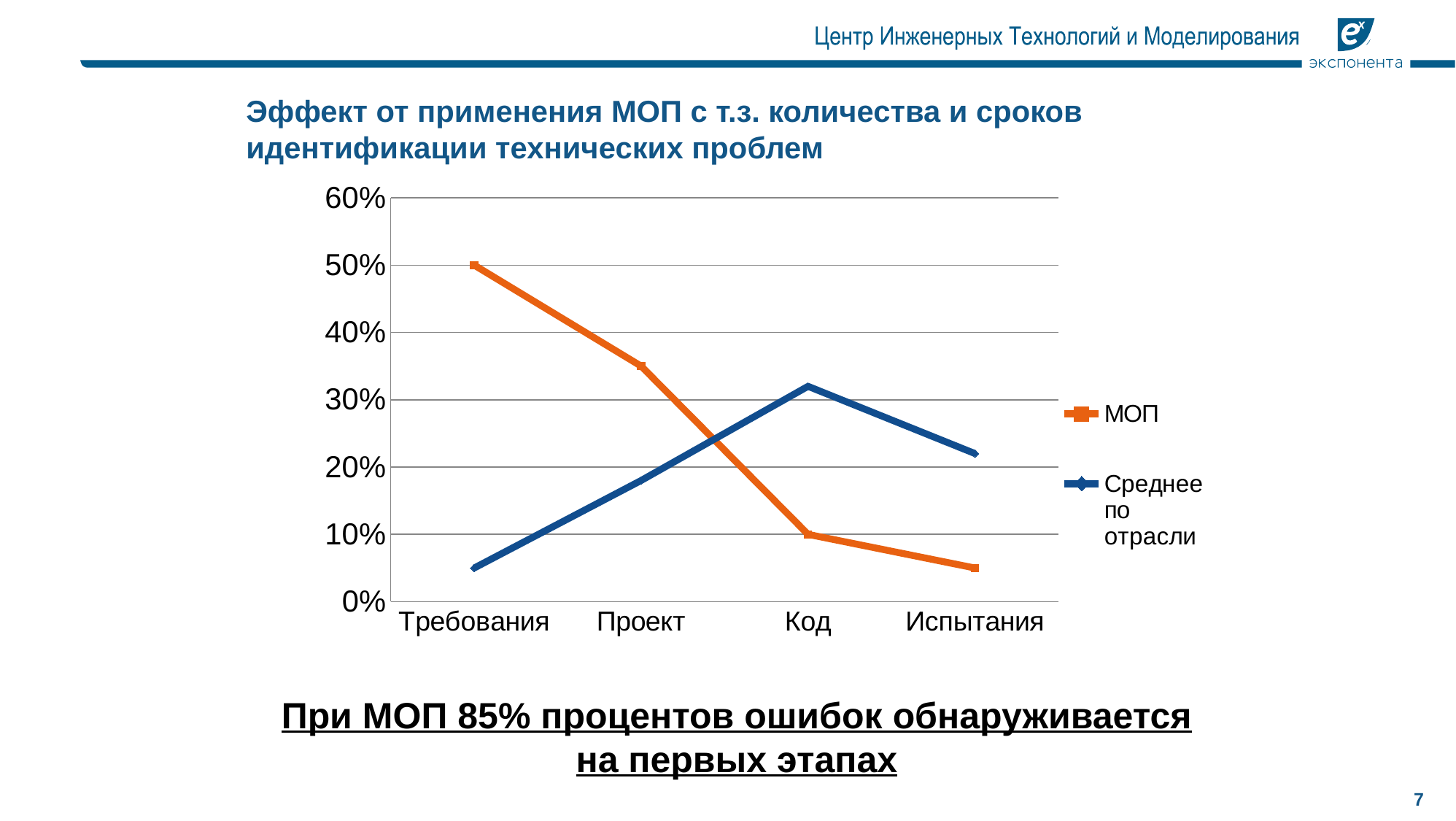
Is the value of Среднее по отрасли at Требования greater or less than 10%? less Is the value of the МОП series at Проект greater or less than 30%? greater How many categories are shown on the x axis? 4 What kind of chart is shown on the slide? line chart Which series has the larger value at Код, МОП or Среднее по отрасли? Среднее по отрасли Is the value of Среднее по отрасли at Код greater or less than 30%? greater At which category is the Среднее по отрасли series lowest? Требования What is the value of the МОП series at Требования? 50% Does the МОП series rise or fall from Требования to Испытания? fall How many series does the legend list? 2 At which category is the МОП series highest? Требования What is the value of the МОП series at Код? 10%